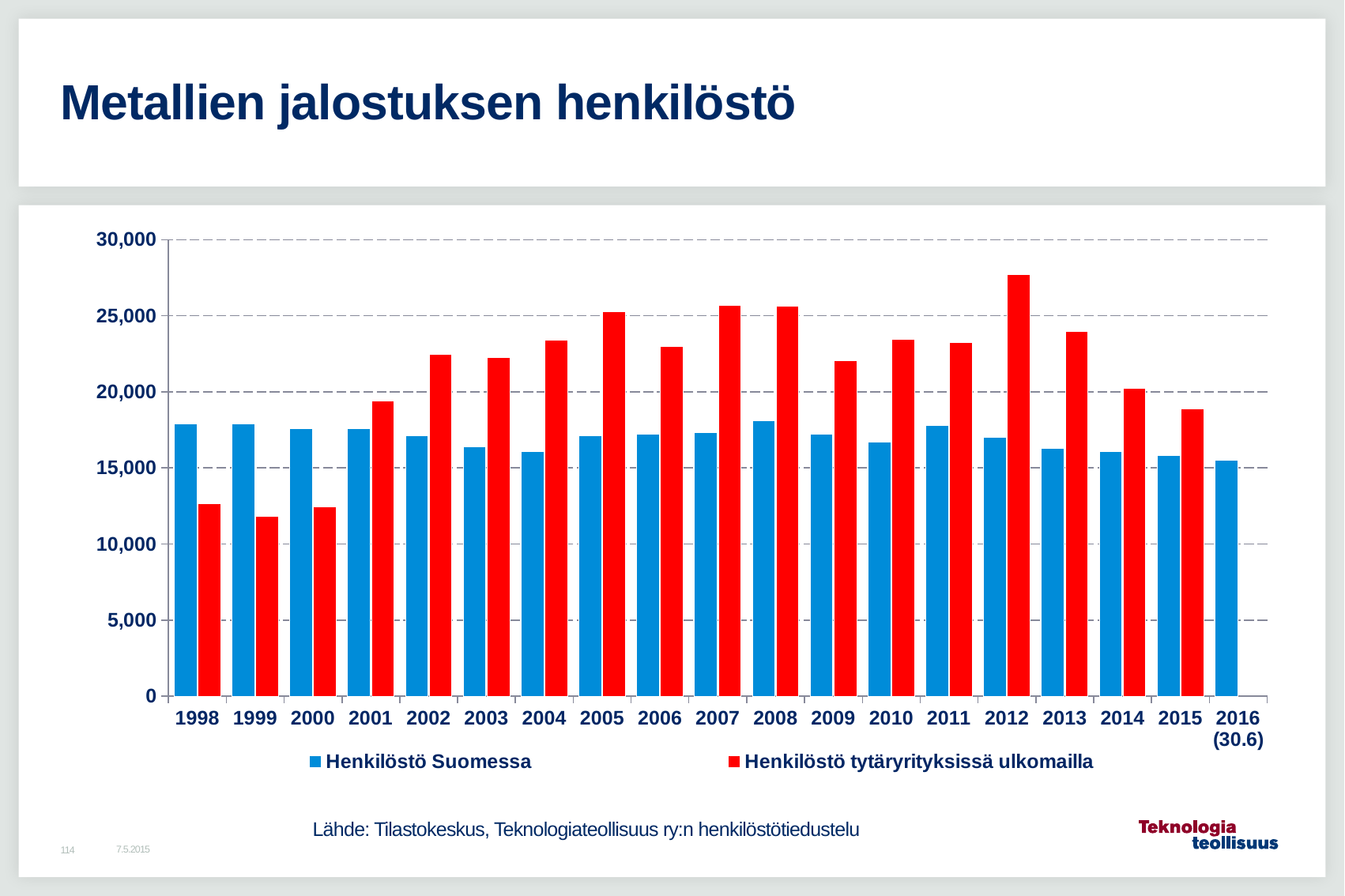
What kind of chart is shown on the slide? bar chart Is the value for Henkilöstö tytäryrityksissä ulkomailla in 2012 greater or less than 25,000? greater Does the value for Henkilöstö Suomessa rise or fall from 2011 to 2016 (30.6)? fall In 1998, which series has the larger value: Henkilöstö Suomessa or Henkilöstö tytäryrityksissä ulkomailla? Henkilöstö Suomessa In 2012, which series has the larger value: Henkilöstö Suomessa or Henkilöstö tytäryrityksissä ulkomailla? Henkilöstö tytäryrityksissä ulkomailla How many years (categories) are shown on the x axis? 19 In which year is the value for Henkilöstö tytäryrityksissä ulkomailla lowest? 1999 In which year is the value for Henkilöstö tytäryrityksissä ulkomailla highest? 2012 Is the value for Henkilöstö tytäryrityksissä ulkomailla in 1999 greater or less than 15,000? less How many series does the legend list? 2 Is the value for Henkilöstö tytäryrityksissä ulkomailla in 2015 greater or less than 20,000? less